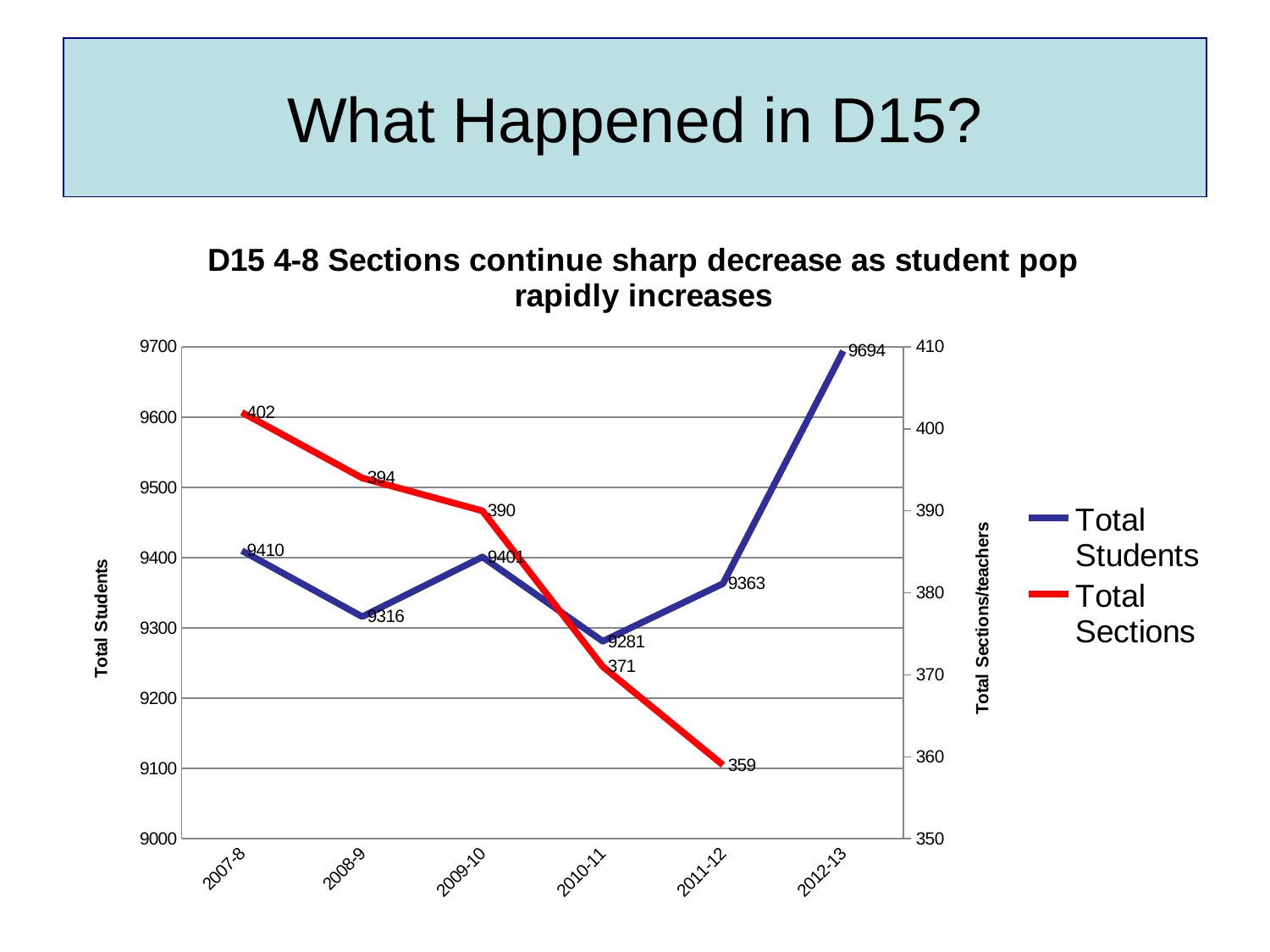
What is the difference between Total Students in 2012-13 and 2011-12? 331 What is the value of Total Students in 2008-9? 9316 Does Total Sections rise or fall from 2007-8 to 2011-12? fall What is the difference between Total Sections in 2007-8 and 2011-12? 43 Which is larger, Total Students in 2007-8 or in 2009-10? 2007-8 How many series does the legend list? 2 What is the value of Total Sections in 2009-10? 390 In which year is Total Sections lowest? 2011-12 What is the value of Total Students in 2012-13? 9694 In which year is Total Students highest? 2012-13 What kind of chart is shown? line chart In which year is Total Students lowest? 2010-11